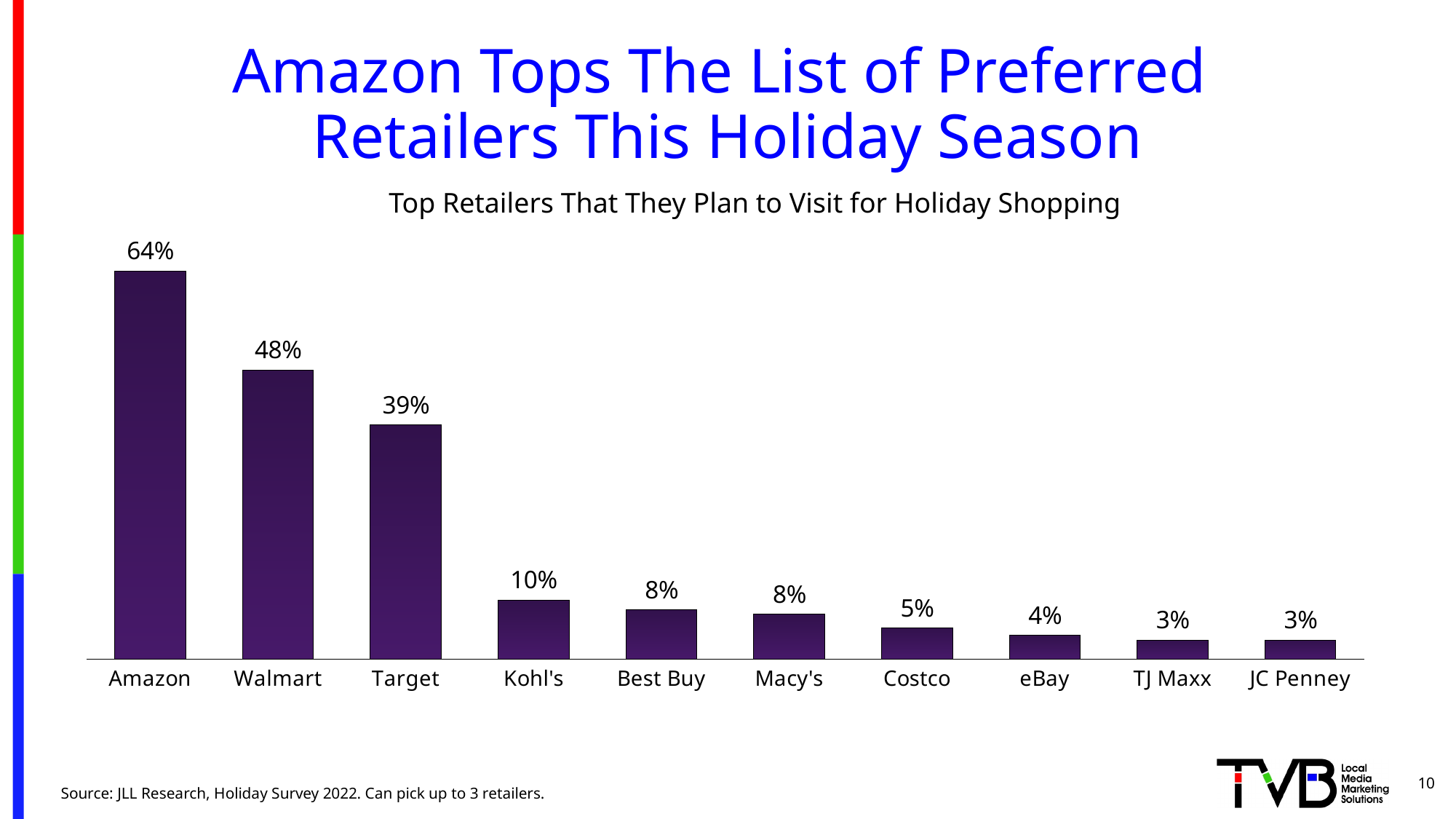
What is the value shown for Kohl's? 10% Which has a larger value, Target or Best Buy? Target What is the value shown for Costco? 5% What is the title of the chart? Top Retailers That They Plan to Visit for Holiday Shopping How many retailers are shown in the chart? 10 Which has a larger value, Costco or eBay? Costco What is the difference between the values for Target and Kohl's? 29% What is the value shown for Walmart? 48% What kind of chart is shown on the slide? Bar chart Which retailer has the highest value in the chart? Amazon What is the difference between the values for Amazon and Walmart? 16% What percentage of respondents plan to visit Amazon for holiday shopping? 64%